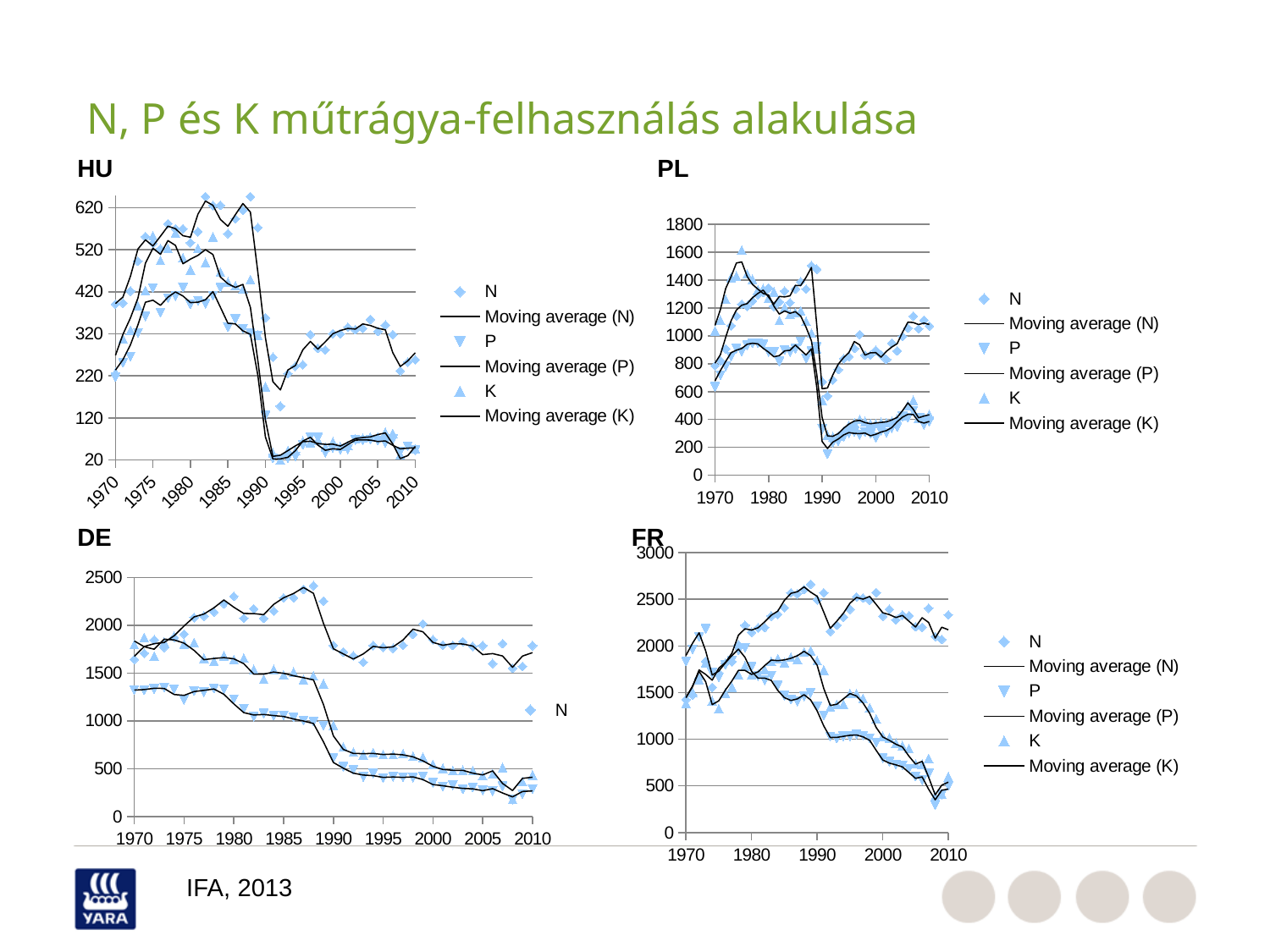
In the HU chart, how many entries does the legend list? 6 How many charts are shown on the slide? 4 In the DE chart, how many entries does the legend list? 1 In the FR chart, is the value for P in 2008 greater or less than 1000? less In the FR chart, does the value for K rise or fall from 1990 to 2010? fall In the PL chart, which is larger in 2010, the value for N or the value for K? N In the DE chart, does the value for P rise or fall from 1970 to 2010? fall In the PL chart, is the value for K in 2010 greater or less than 600? less In the DE chart, is the value for N in 2010 greater or less than 1500? greater In the HU chart, which series has the highest values in 1985? N In the PL chart, what are the three data series shown with markers? N, P and K